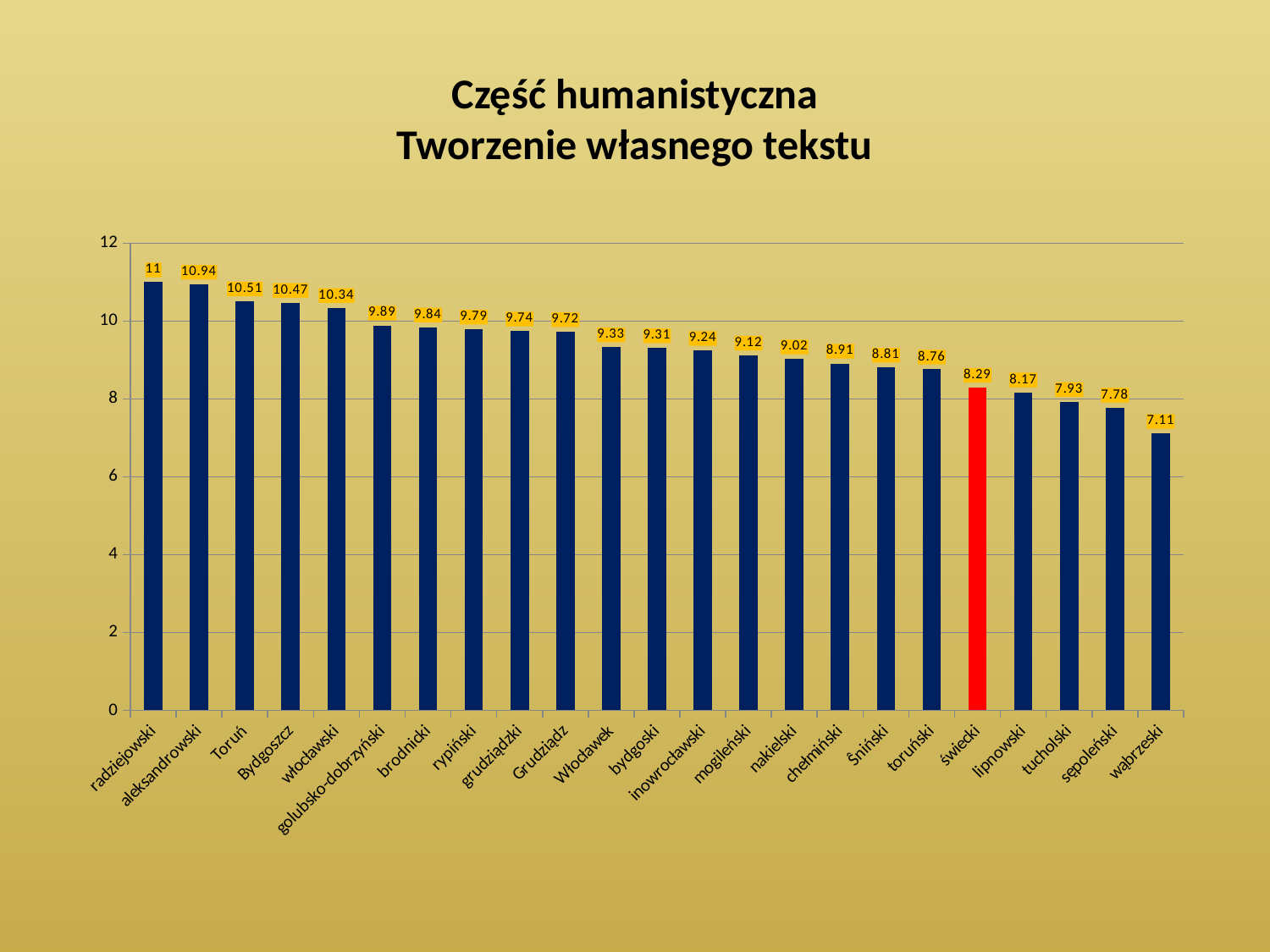
What is the value for wąbrzeski? 7.11 How many categories are shown on the x axis? 23 Which category has the lowest value? wąbrzeski What is the difference between the values for Bydgoszcz and świecki? 2.18 What kind of chart is shown on the slide? bar chart Which category has the highest value? radziejowski What is the value for świecki? 8.29 Which bar is coloured red instead of dark blue? świecki What is the difference between the values for radziejowski and wąbrzeski? 3.89 Which is larger, the value for brodnicki or the value for lipnowski? brodnicki Is the value for tucholski greater or less than 8? less What is the value for Toruń? 10.51